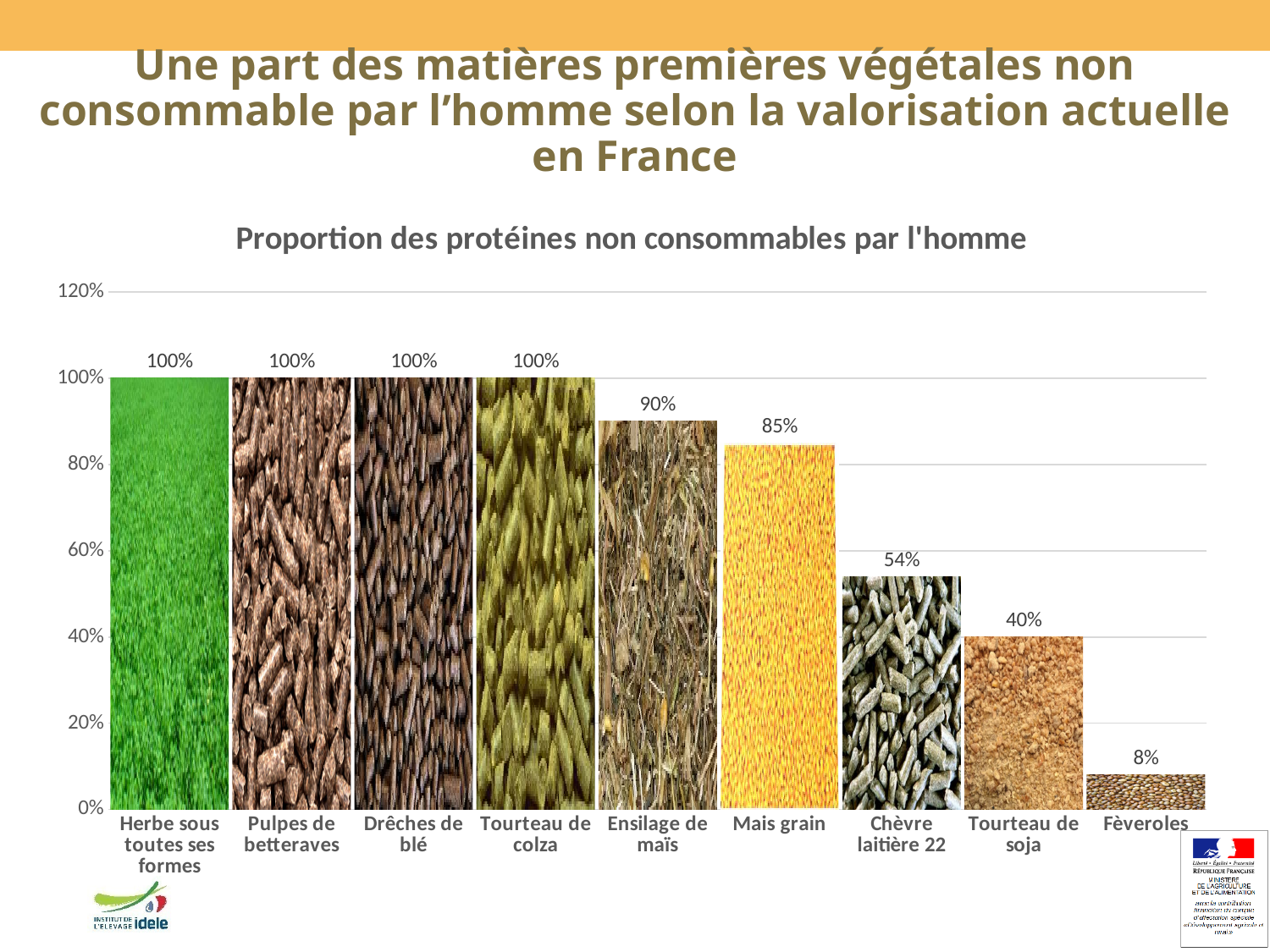
What is the value for Chèvre laitière 22? 54% What is the difference between the values for Chèvre laitière 22 and Tourteau de soja? 14% Is the value for Chèvre laitière 22 greater or less than 60%? less How many categories are shown on the x axis? 9 Which is larger, the value for Tourteau de soja or the value for Fèveroles? Tourteau de soja What kind of chart is shown? bar chart What is the title of the chart? Proportion des protéines non consommables par l'homme What is the difference between the values for Ensilage de maïs and Mais grain? 5% What is the value for Tourteau de soja? 40% What is the value for Ensilage de maïs? 90% Which category has the lowest value? Fèveroles What is the value for Mais grain? 85%